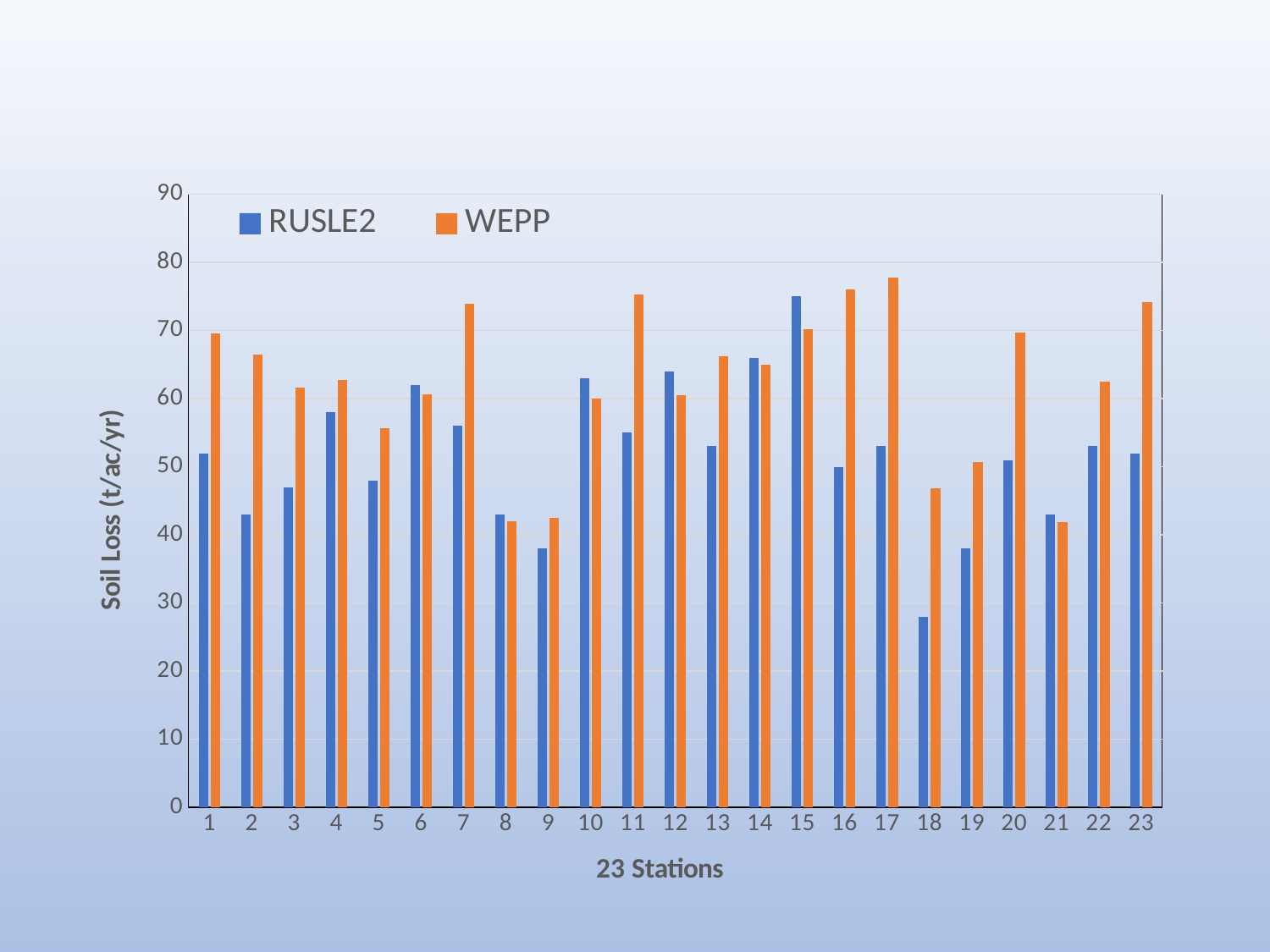
How many series does the legend list? 2 Is the WEPP value for station 17 greater or less than 70? greater Is the RUSLE2 value for station 9 greater or less than 40? less How many stations are shown on the x axis? 23 What is the label of the y axis? Soil Loss (t/ac/yr) Which colour represents the WEPP series? orange Is the RUSLE2 value for station 18 greater or less than 30? less Which station has the highest RUSLE2 soil loss? 15 At station 7, which series has the larger soil loss, RUSLE2 or WEPP? WEPP What kind of chart is shown on the slide? bar chart Which station has the lowest RUSLE2 soil loss? 18 At station 15, which series has the larger soil loss, RUSLE2 or WEPP? RUSLE2